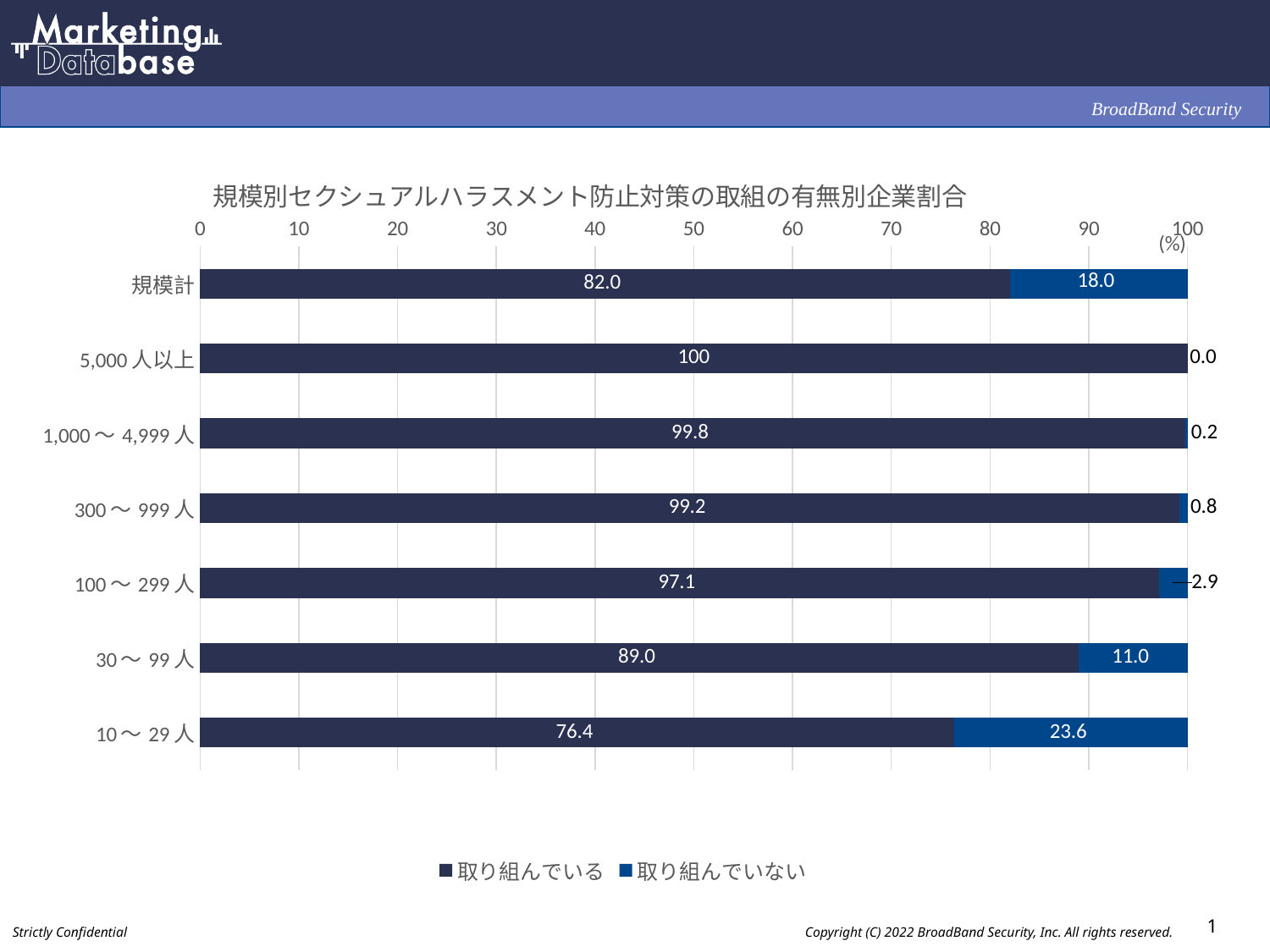
What type of chart is shown on the slide? Stacked bar chart What is the difference between the 取り組んでいない values for 10～29人 and 30～99人? 12.6 What is the value of 取り組んでいる for 規模計? 82.0 Which category has the highest value for 取り組んでいる? 5,000人以上 What is the value of 取り組んでいない for 10～29人? 23.6 How many series does the legend list? 2 Which is larger: the 取り組んでいる value for 30～99人 or for 規模計? 30～99人 Which category has the lowest value for 取り組んでいる? 10～29人 What is the title of the chart? 規模別セクシュアルハラスメント防止対策の取組の有無別企業割合 How many categories are shown on the chart? 7 What is the value of 取り組んでいる for 100～299人? 97.1 What is the value of 取り組んでいない for 300～999人? 0.8